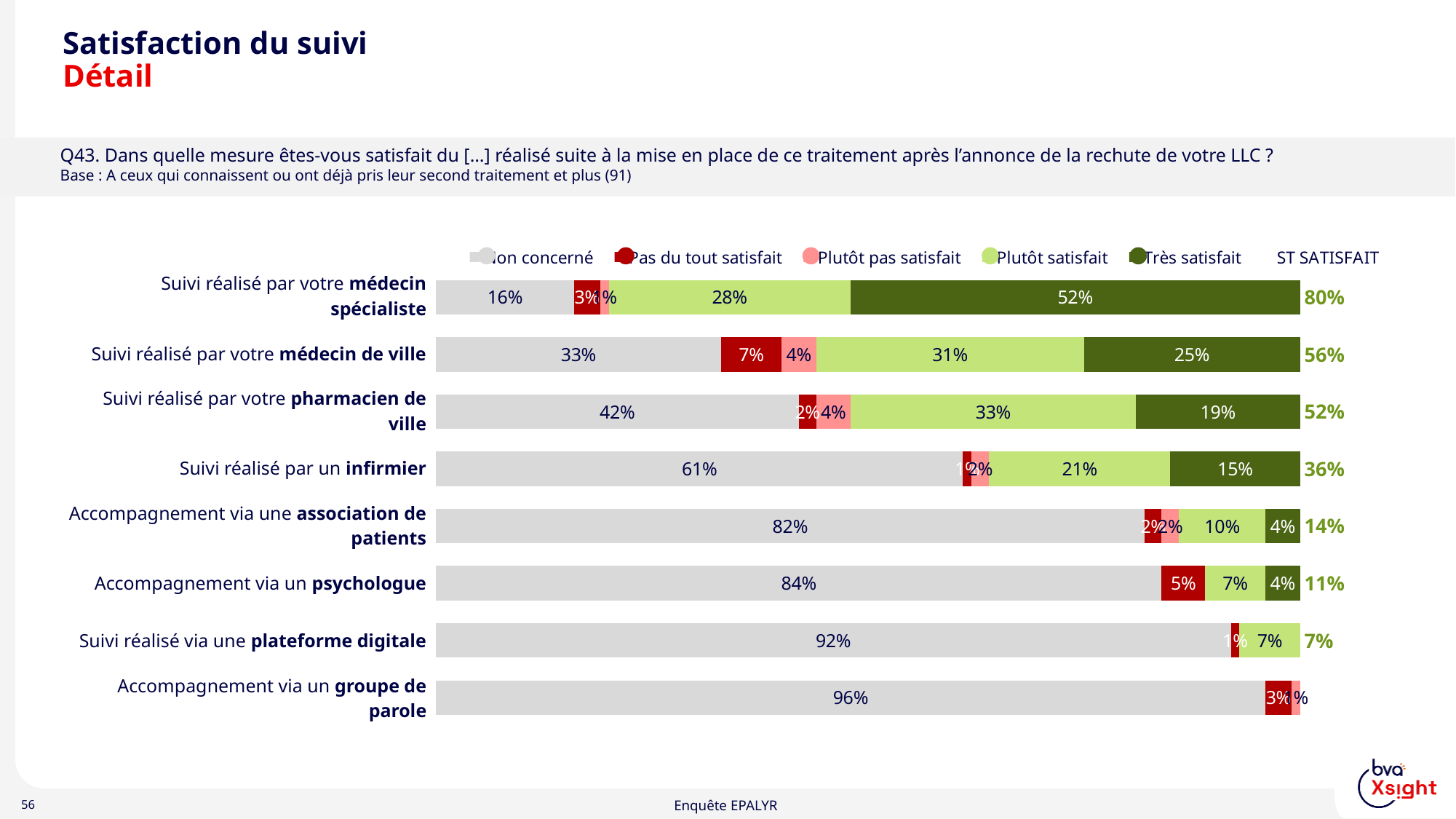
What is the difference between the 'Très satisfait' values for 'médecin spécialiste' and 'médecin de ville'? 27 points How many categories (bars) are shown in the chart? 8 What is the ST SATISFAIT value for 'Accompagnement via un psychologue'? 11% What is the 'Pas du tout satisfait' value for 'Suivi réalisé par votre médecin de ville'? 7% Which category has the highest 'Non concerné' value? Accompagnement via un groupe de parole What is the 'Non concerné' value for 'Suivi réalisé par un infirmier'? 61% What kind of chart is shown on the slide? Stacked bar chart What is the 'Plutôt satisfait' value for 'Suivi réalisé par votre pharmacien de ville'? 33% What is the 'Très satisfait' value for 'Suivi réalisé par votre médecin spécialiste'? 52% Which category has the lowest 'Non concerné' value? Suivi réalisé par votre médecin spécialiste Which has the larger 'Plutôt satisfait' value: 'médecin de ville' or 'pharmacien de ville'? Pharmacien de ville How many series does the legend list? 5